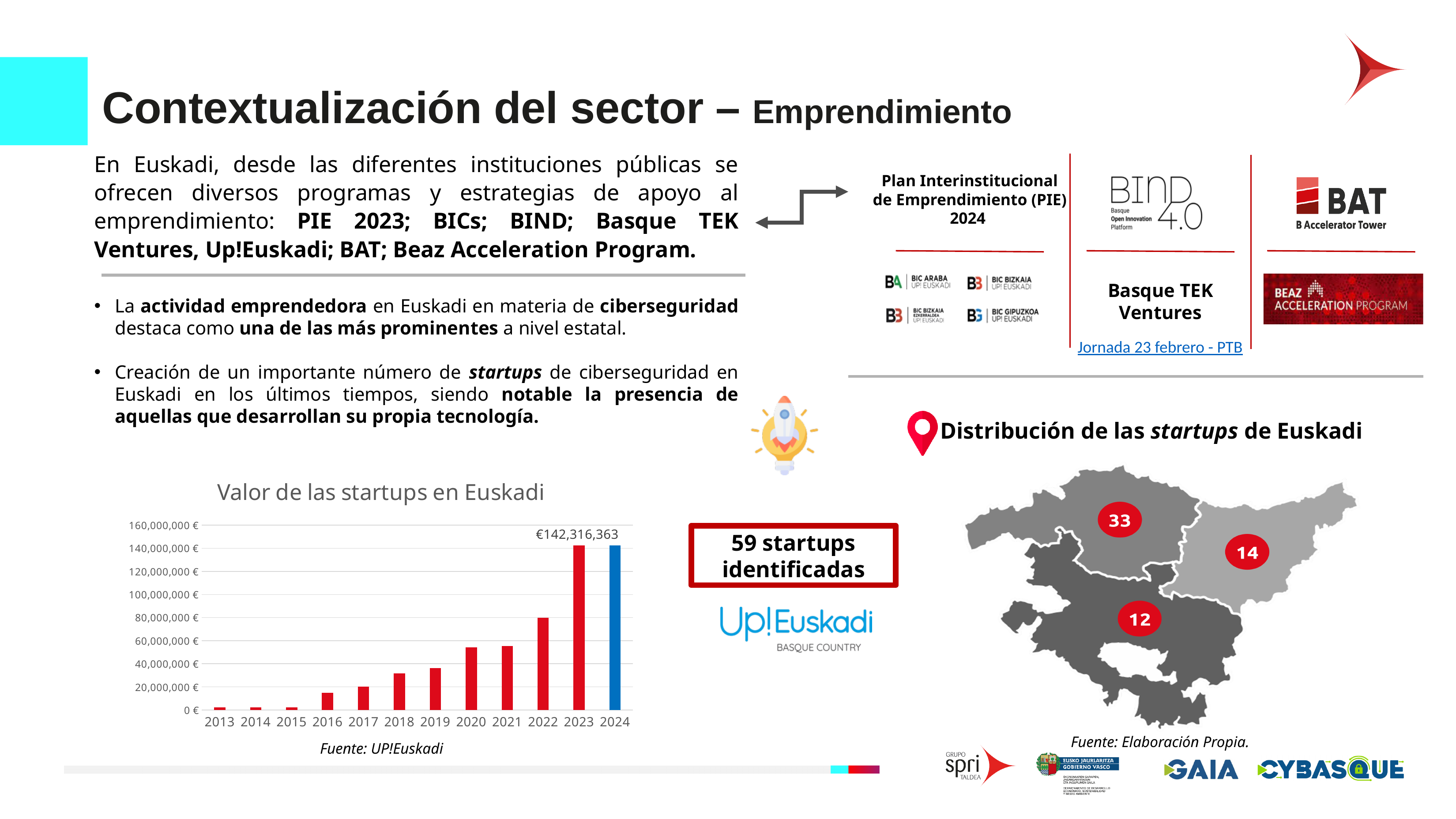
What value is printed as a data label on the 'Valor de las startups en Euskadi' chart? €142,316,363 In the 'Valor de las startups en Euskadi' chart, which year has the larger value, 2018 or 2021? 2021 In the 'Valor de las startups en Euskadi' chart, is the value for 2016 greater or less than 20,000,000 €? less How many years are shown on the x axis of the 'Valor de las startups en Euskadi' chart? 12 In the 'Valor de las startups en Euskadi' chart, is the value for 2019 greater or less than 40,000,000 €? less In the 'Valor de las startups en Euskadi' chart, is the value for 2020 greater or less than 40,000,000 €? greater In the 'Valor de las startups en Euskadi' chart, which year has the larger value, 2022 or 2019? 2022 What kind of chart is 'Valor de las startups en Euskadi'? bar chart What is the title of the chart at the bottom left of the slide? Valor de las startups en Euskadi In the 'Valor de las startups en Euskadi' chart, do the values generally rise or fall from 2013 to 2024? rise In the 'Valor de las startups en Euskadi' chart, which year's bar is coloured blue instead of red? 2024